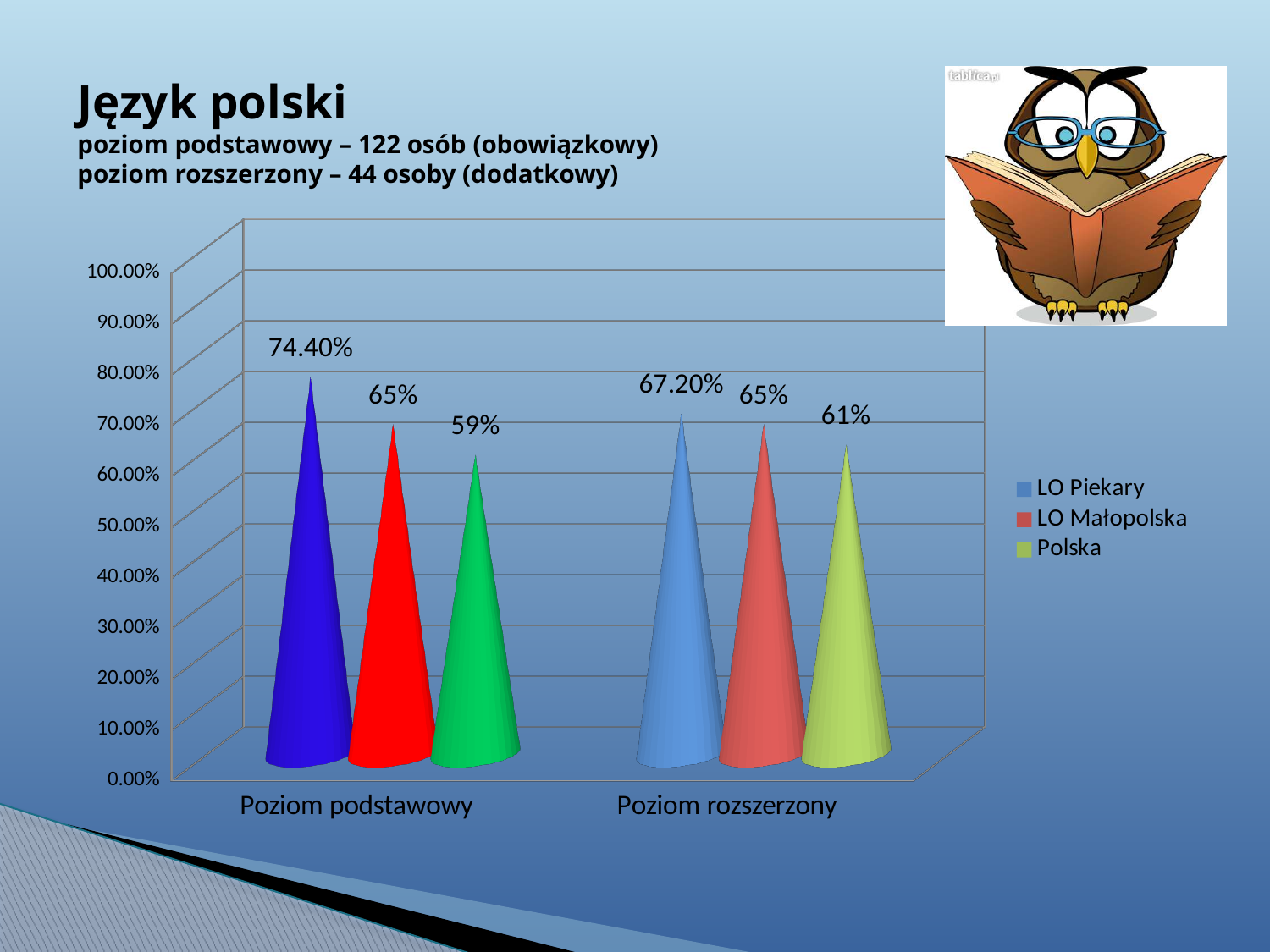
What is the difference between LO Piekary and Polska at Poziom podstawowy? 15.40% How many categories are shown on the x axis? 2 What is the value for LO Piekary at Poziom rozszerzony? 67.20% What is the value for LO Piekary at Poziom podstawowy? 74.40% Which series has the lowest value at Poziom rozszerzony? Polska What kind of chart is shown on the slide? bar chart Which series has the highest value at Poziom podstawowy? LO Piekary What is the difference between LO Piekary and LO Małopolska at Poziom rozszerzony? 2.20% How many series does the legend list? 3 What is the value for LO Małopolska at Poziom podstawowy? 65% What is the value for Polska at Poziom rozszerzony? 61% Which is larger: LO Piekary at Poziom podstawowy or LO Piekary at Poziom rozszerzony? Poziom podstawowy